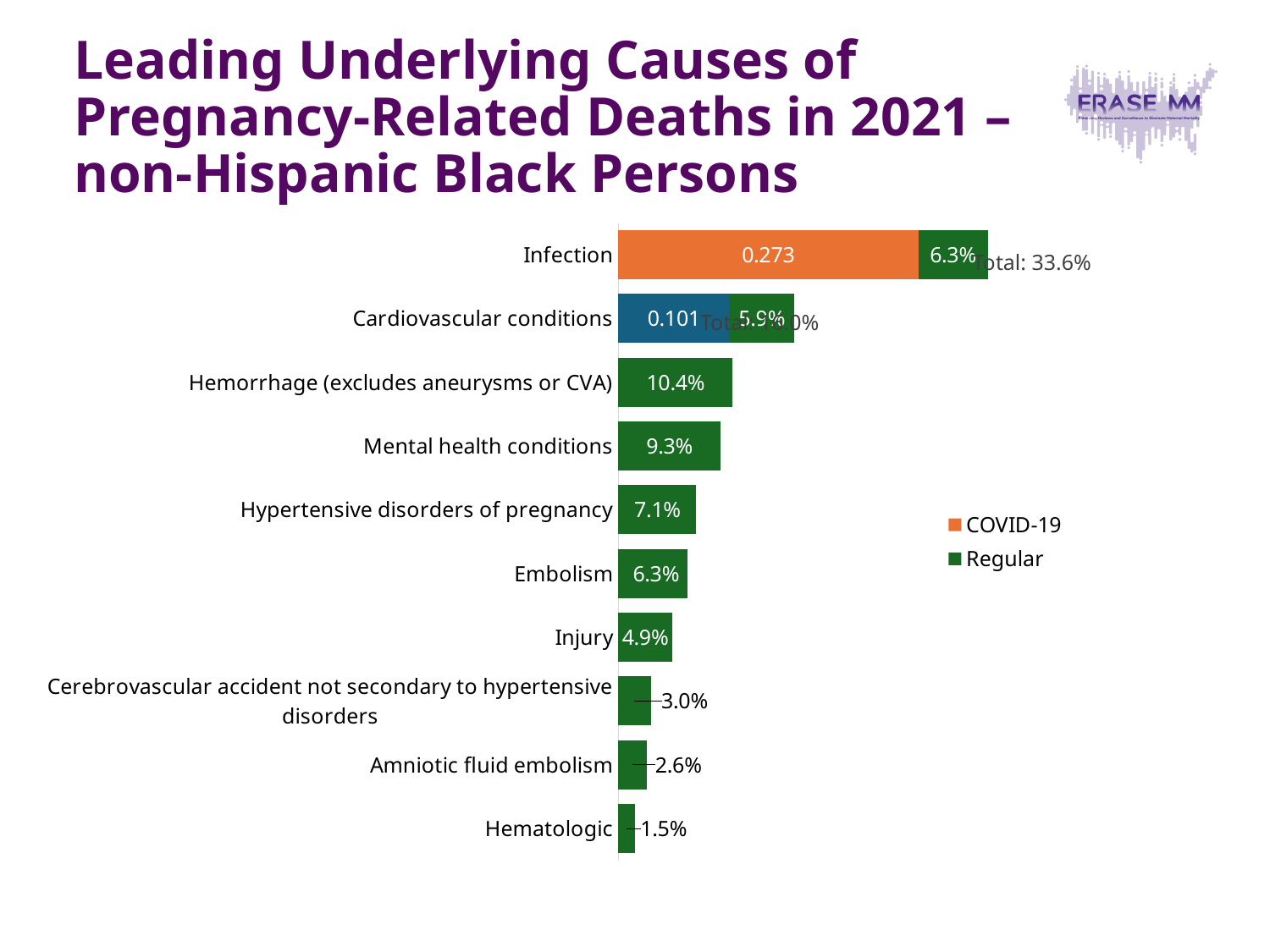
What kind of chart is shown on the slide? Bar chart Which cause has the longest bar on the chart? Infection How many series does the legend list? 2 How many causes of death are listed on the chart? 10 What is the value for Mental health conditions? 9.3% What is the value for Hemorrhage (excludes aneurysms or CVA)? 10.4% What is the total shown for the Infection bar? 33.6% What is the value for Hypertensive disorders of pregnancy? 7.1% Which cause has the lowest value on the chart? Hematologic What is the value for Injury? 4.9% Which series is shown in orange in the legend? COVID-19 What is the difference between the values for Hemorrhage (excludes aneurysms or CVA) and Mental health conditions? 1.1%